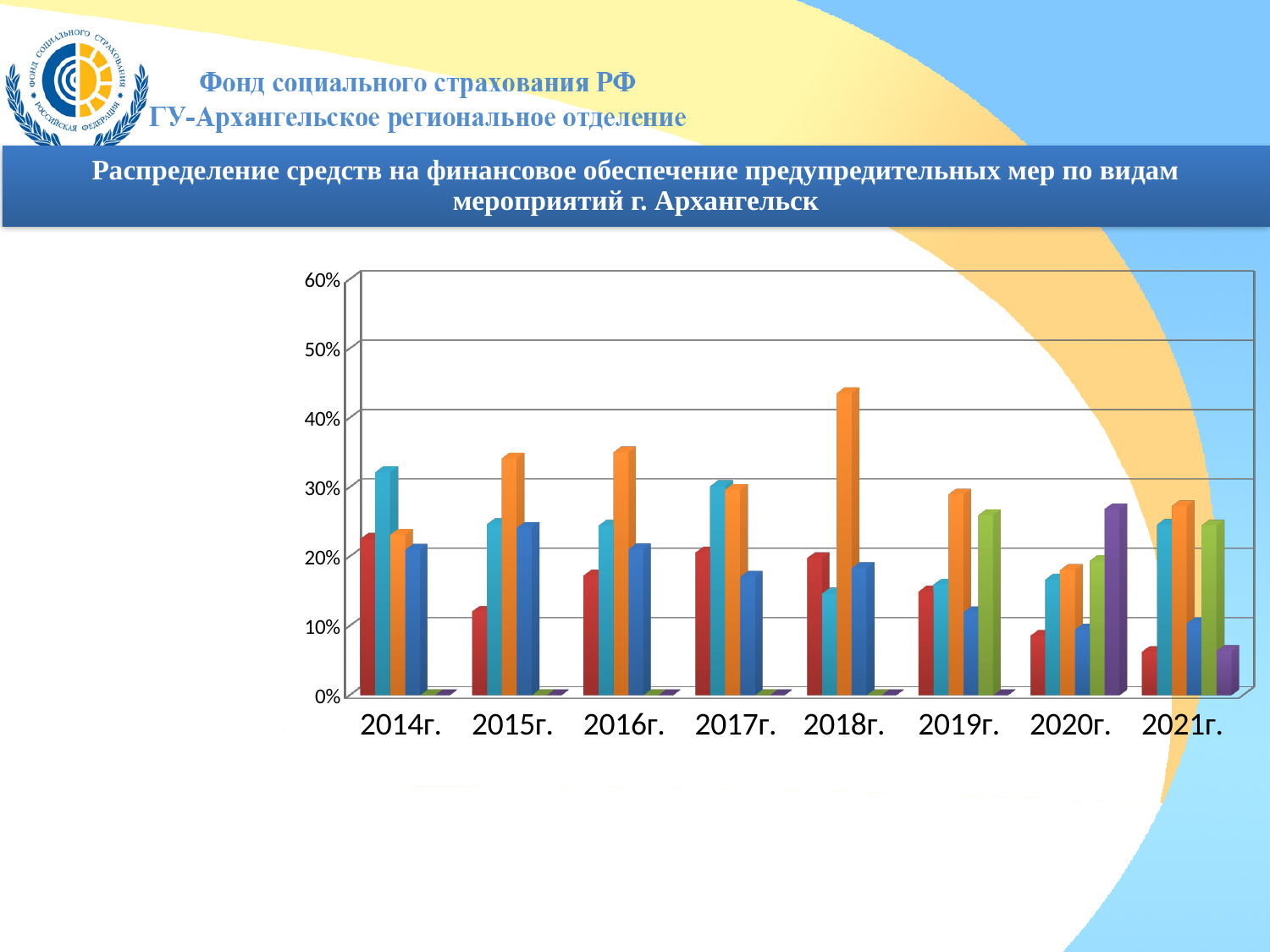
Which year has the shortest red bar in the chart? 2021г. How many year categories are shown on the x axis of the chart? 8 Which year has the tallest orange bar in the chart? 2018г. What kind of chart is shown on the slide? bar chart Is the value of the light blue bar for 2014г. greater or less than 30%? greater Which year has the larger red bar, 2014г. or 2021г.? 2014г. Which year has the larger green bar, 2019г. or 2020г.? 2019г. Is the value of the red bar for 2021г. greater or less than 10%? less What is the highest value shown on the vertical axis of the chart? 60% Is the value of the orange bar for 2018г. greater or less than 40%? greater Which is larger in 2018г., the orange bar or the light blue bar? the orange bar